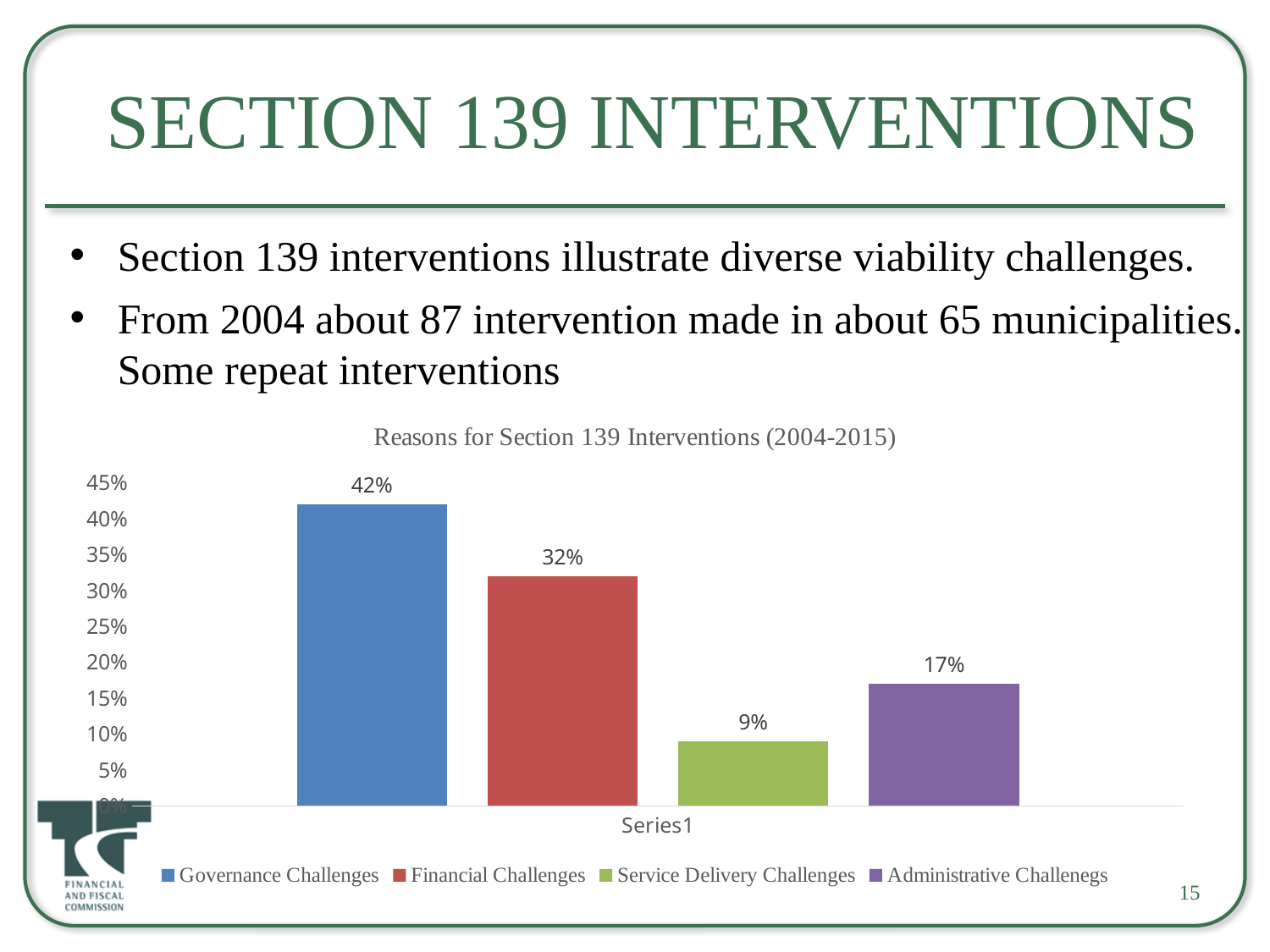
What is the value for Financial Challenges? 32% Which is larger, Financial Challenges or Administrative Challenegs? Financial Challenges What is the difference between Governance Challenges and Financial Challenges? 10% What is the difference between Administrative Challenegs and Service Delivery Challenges? 8% What is the value for Governance Challenges? 42% Which category has the lowest value? Service Delivery Challenges What is the title of the chart? Reasons for Section 139 Interventions (2004-2015) Which category has the highest value? Governance Challenges What is the value for Administrative Challenegs? 17% What is the value for Service Delivery Challenges? 9% How many series does the legend list? 4 What kind of chart is shown? Bar chart